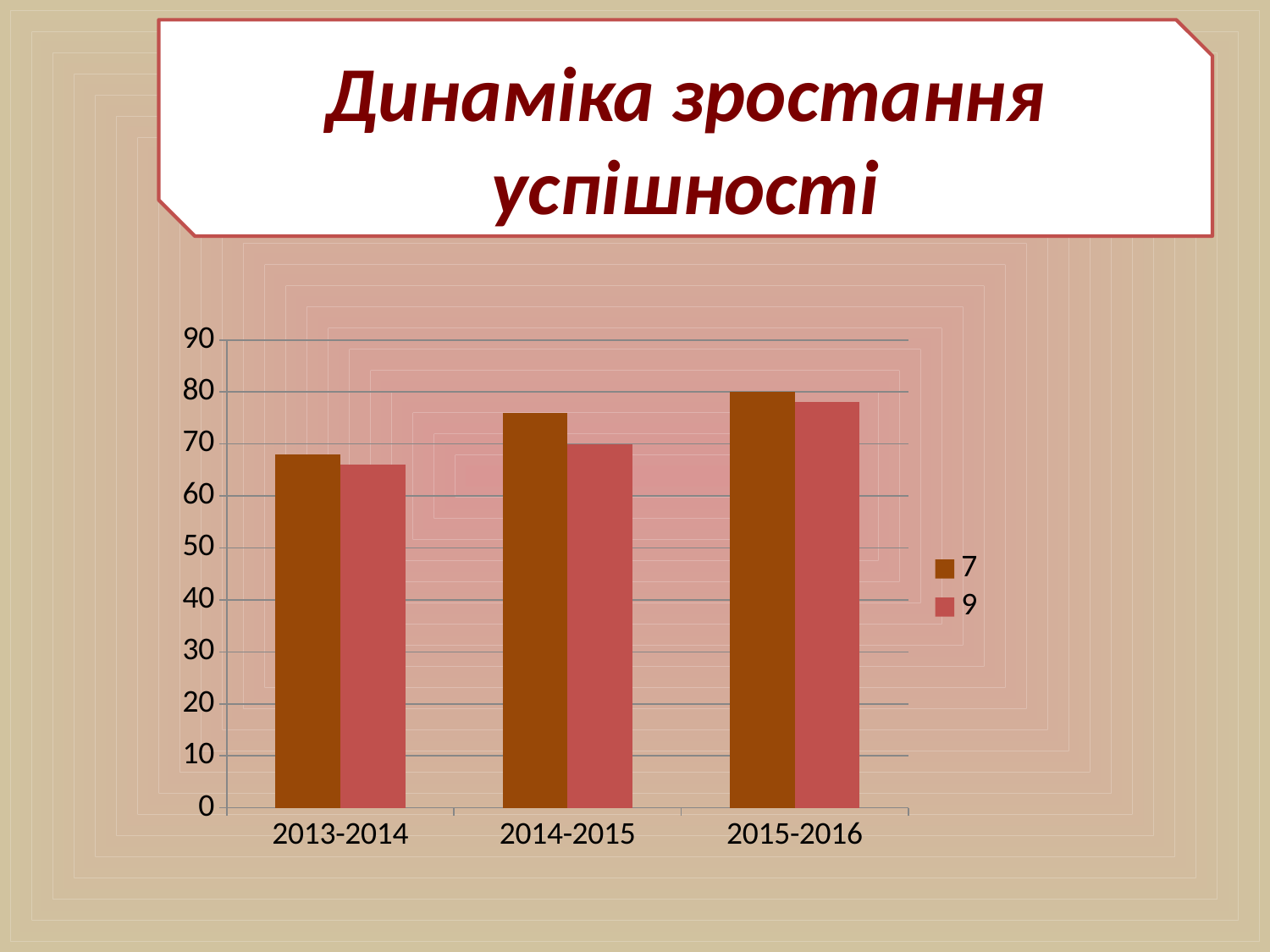
How many categories are shown on the x axis? 3 Which category has the lowest value for series 9? 2013-2014 Do the values for series 7 rise or fall from 2013-2014 to 2015-2016? rise What kind of chart is shown on the slide? bar chart Which legend entry is shown in brown? 7 Which category has the highest value for series 7? 2015-2016 Is the value for series 7 in 2014-2015 greater or less than 70? greater Is the value for series 7 in 2013-2014 greater or less than 60? greater Is the value for series 9 in 2013-2014 greater or less than 70? less What is the title of the chart on the slide? Динаміка зростання успішності In 2014-2015, which series has the larger value, 7 or 9? 7 How many series does the legend list? 2